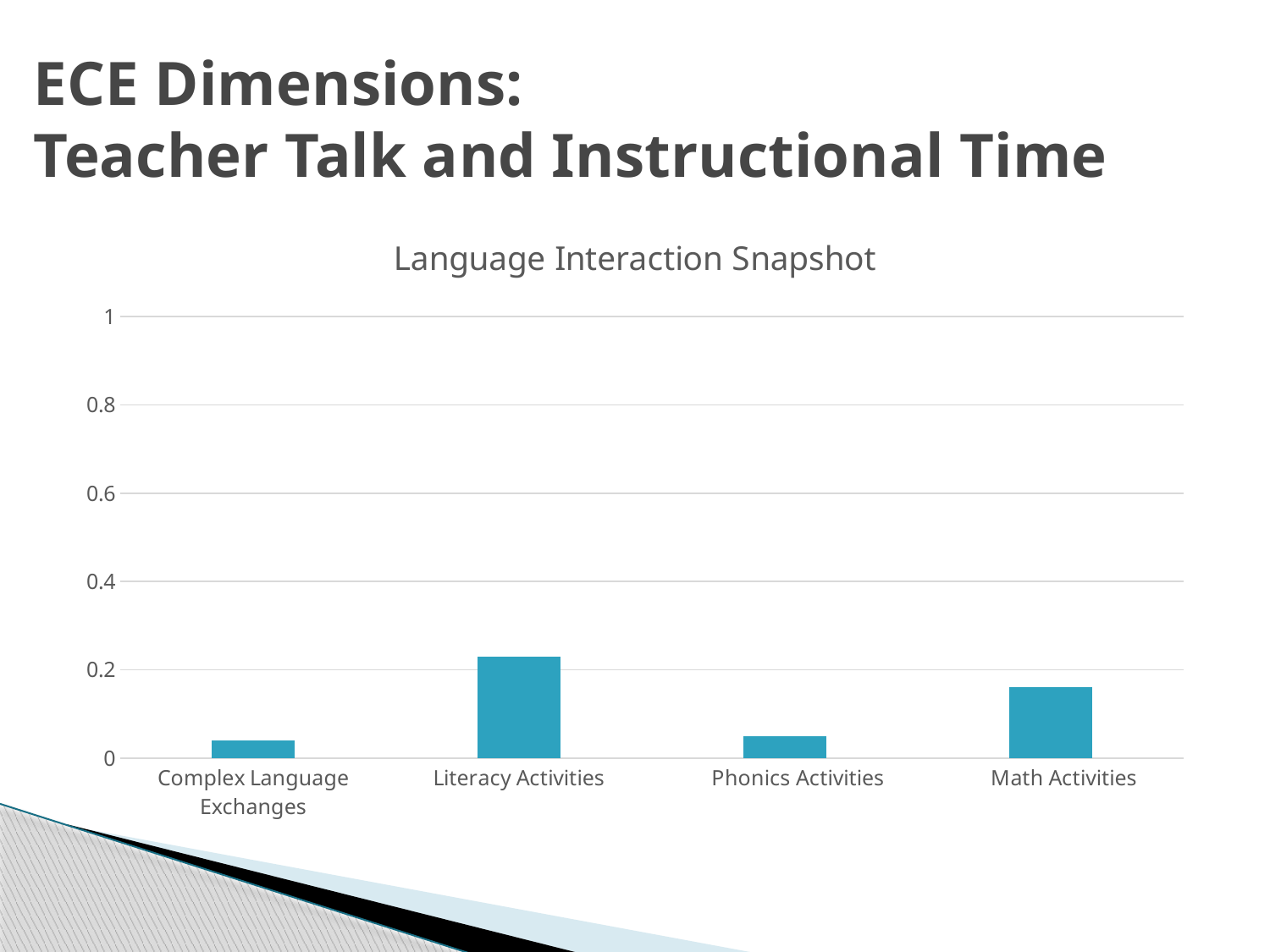
What kind of chart is shown on the slide? bar chart Is the value for Math Activities greater or less than 0.2? less Is the value for Complex Language Exchanges greater or less than 0.2? less What is the title of the chart? Language Interaction Snapshot What is the highest value shown on the y axis of the chart? 1 How many categories are shown on the x axis of the chart? 4 Is the value for Literacy Activities greater or less than 0.2? greater Which is larger, the value for Math Activities or the value for Phonics Activities? Math Activities Which category has the highest value in the chart? Literacy Activities Which is larger, the value for Literacy Activities or the value for Math Activities? Literacy Activities Which is larger, the value for Literacy Activities or the value for Complex Language Exchanges? Literacy Activities